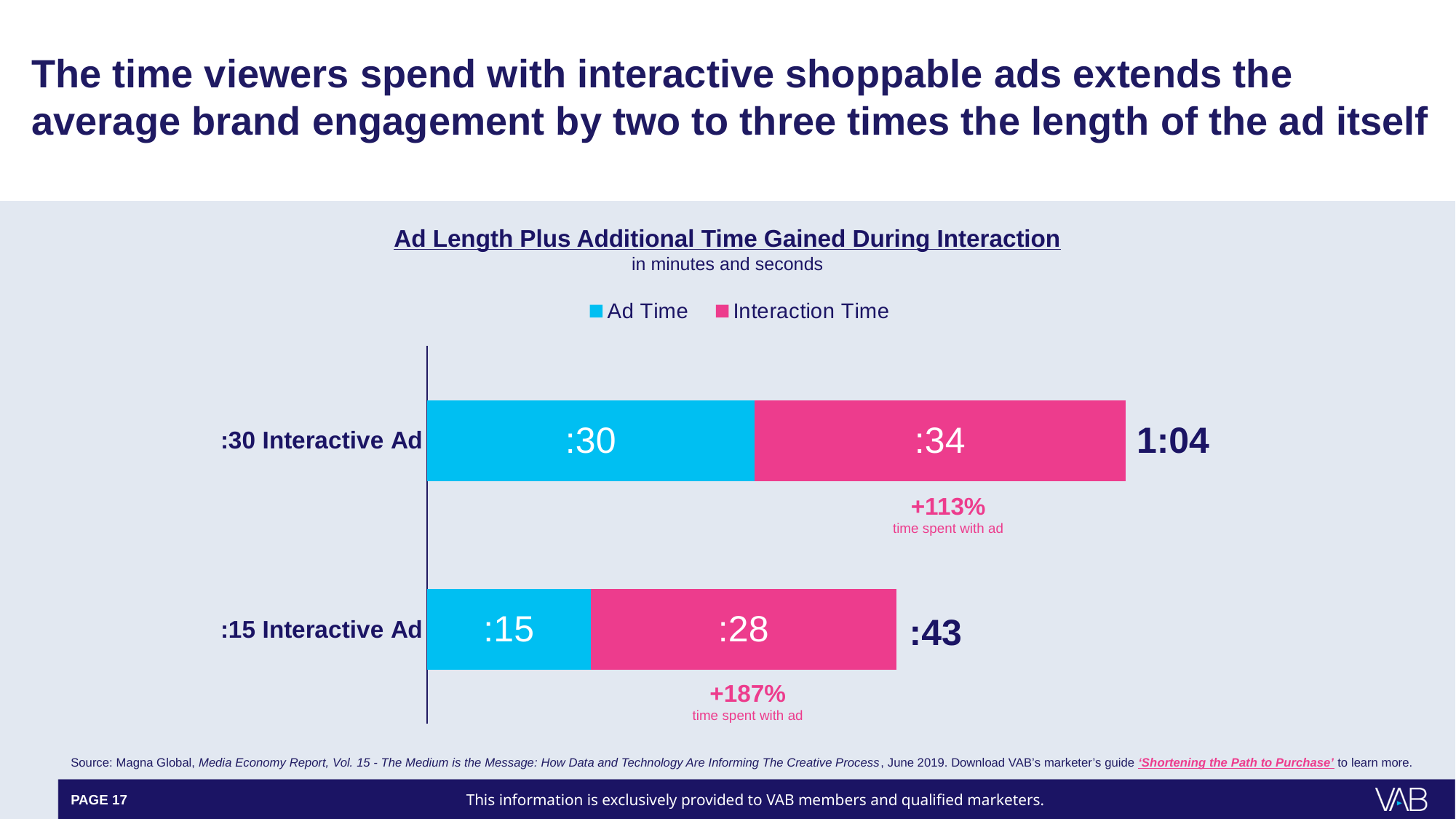
How many series does the legend list? 2 What is the total time shown for the :15 Interactive Ad bar? :43 What type of chart is shown on the slide? Stacked bar chart What is the Interaction Time value for the :15 Interactive Ad? :28 Is the Interaction Time for the :30 Interactive Ad larger or smaller than the Interaction Time for the :15 Interactive Ad? larger Which category has the longer Interaction Time? :30 Interactive Ad What percentage increase in time spent with ad is shown for the :15 Interactive Ad? +187% What is the total time shown for the :30 Interactive Ad bar? 1:04 Which category has the shorter total time? :15 Interactive Ad What is the Interaction Time value for the :30 Interactive Ad? :34 What is the Ad Time value for the :15 Interactive Ad? :15 What percentage increase in time spent with ad is shown for the :30 Interactive Ad? +113%